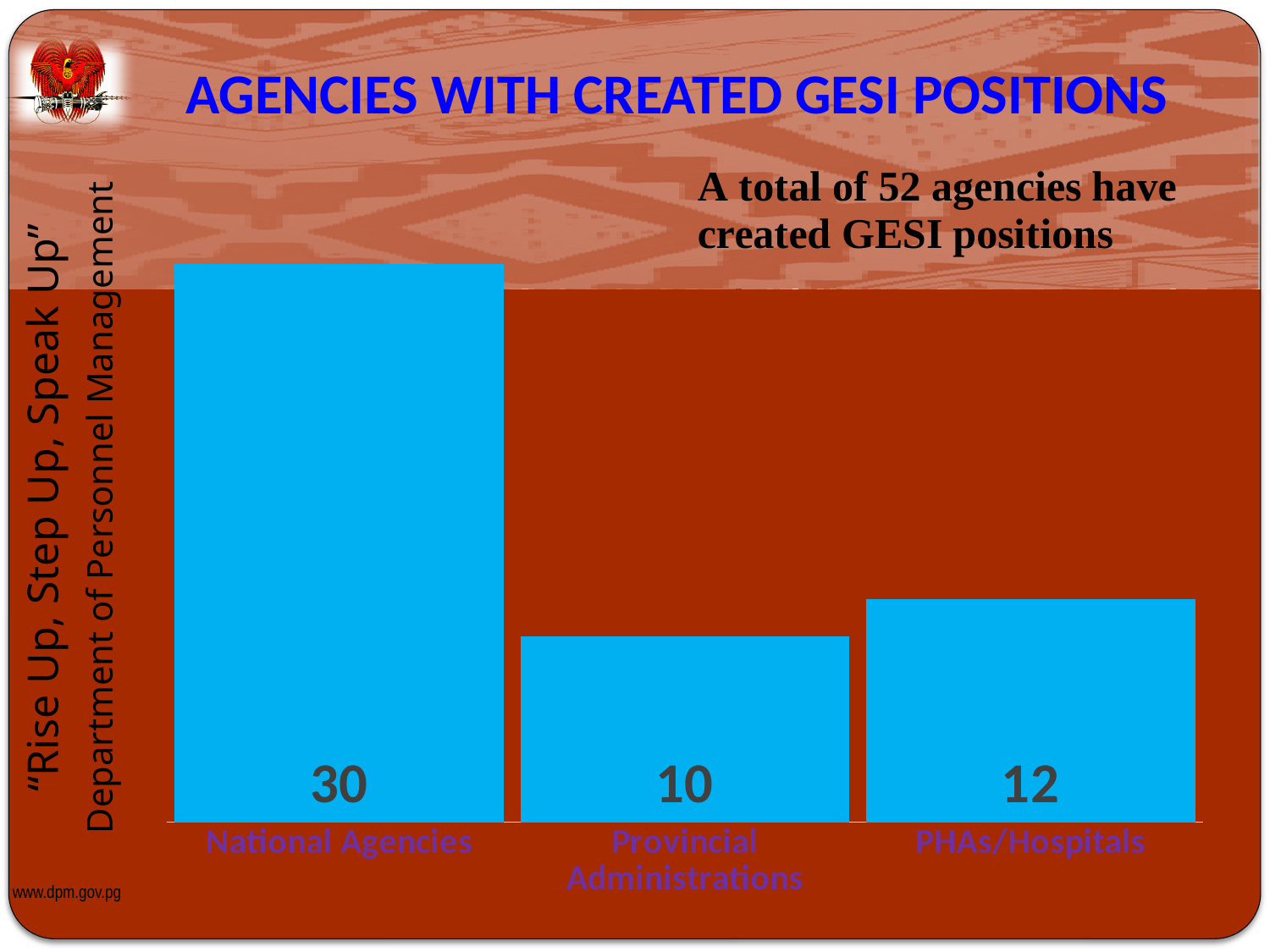
What is the value for National Agencies? 30 Which is larger, the value for PHAs/Hospitals or the value for Provincial Administrations? PHAs/Hospitals What is the title of the chart? AGENCIES WITH CREATED GESI POSITIONS Which category has the lowest value? Provincial Administrations What is the value for PHAs/Hospitals? 12 What is the value for Provincial Administrations? 10 What kind of chart is shown on the slide? Bar chart How many categories are shown in the chart? 3 What is the difference between the values for National Agencies and Provincial Administrations? 20 Which category has the highest value? National Agencies What is the total of the three values shown in the chart? 52 What is the difference between the values for PHAs/Hospitals and Provincial Administrations? 2